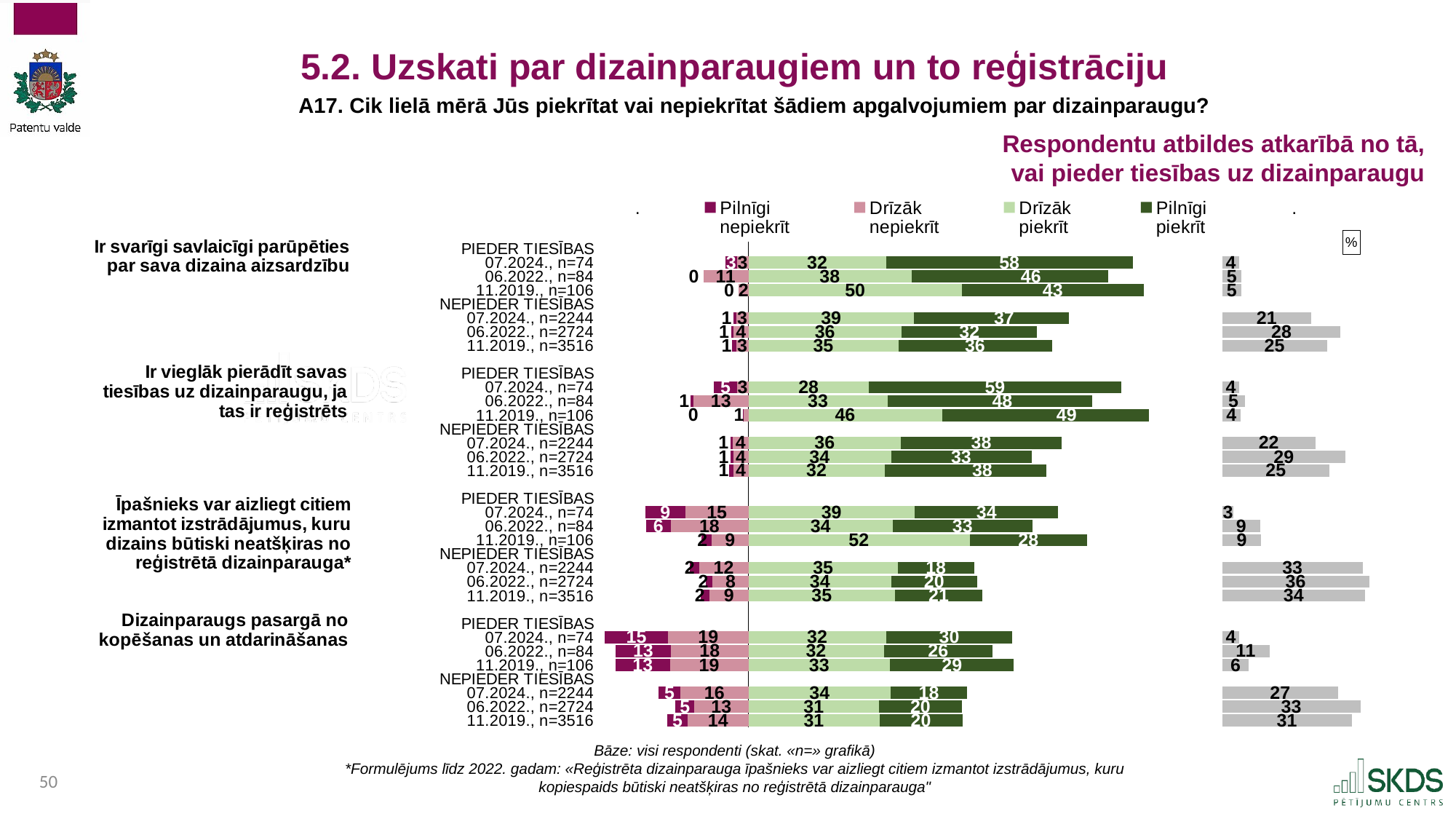
What kind of chart is shown on the slide? Stacked bar chart For the statement "Ir svarīgi savlaicīgi parūpēties par sava dizaina aizsardzību", what is the "Drīzāk piekrīt" value for PIEDER TIESĪBAS, 11.2019., n=106? 50 For the statement "Īpašnieks var aizliegt citiem izmantot izstrādājumus...", what is the "Drīzāk nepiekrīt" value for PIEDER TIESĪBAS, 06.2022., n=84? 18 How many series does the chart legend list? 4 Which legend entry corresponds to the dark green segments of the bars? Pilnīgi piekrīt For the statement "Ir svarīgi savlaicīgi parūpēties par sava dizaina aizsardzību", what is the "Pilnīgi piekrīt" value for PIEDER TIESĪBAS, 07.2024., n=74? 58 For the statement "Ir vieglāk pierādīt savas tiesības uz dizainparaugu, ja tas ir reģistrēts", which PIEDER TIESĪBAS survey wave has the highest "Pilnīgi piekrīt" value? 07.2024., n=74 How many statements about design rights are shown in the chart? 4 For the statement "Dizainparaugs pasargā no kopēšanas un atdarināšanas", what is the "Pilnīgi nepiekrīt" value for PIEDER TIESĪBAS, 07.2024., n=74? 15 For the statement "Dizainparaugs pasargā no kopēšanas un atdarināšanas" in 07.2024., which group has the larger "Pilnīgi piekrīt" value: PIEDER TIESĪBAS or NEPIEDER TIESĪBAS? PIEDER TIESĪBAS For the statement "Īpašnieks var aizliegt citiem izmantot izstrādājumus...", what is the difference between the "Drīzāk piekrīt" values for PIEDER TIESĪBAS in 11.2019. and 07.2024.? 13 For the statement "Īpašnieks var aizliegt citiem izmantot izstrādājumus...", which NEPIEDER TIESĪBAS survey wave has the lowest "Pilnīgi piekrīt" value? 07.2024., n=2244